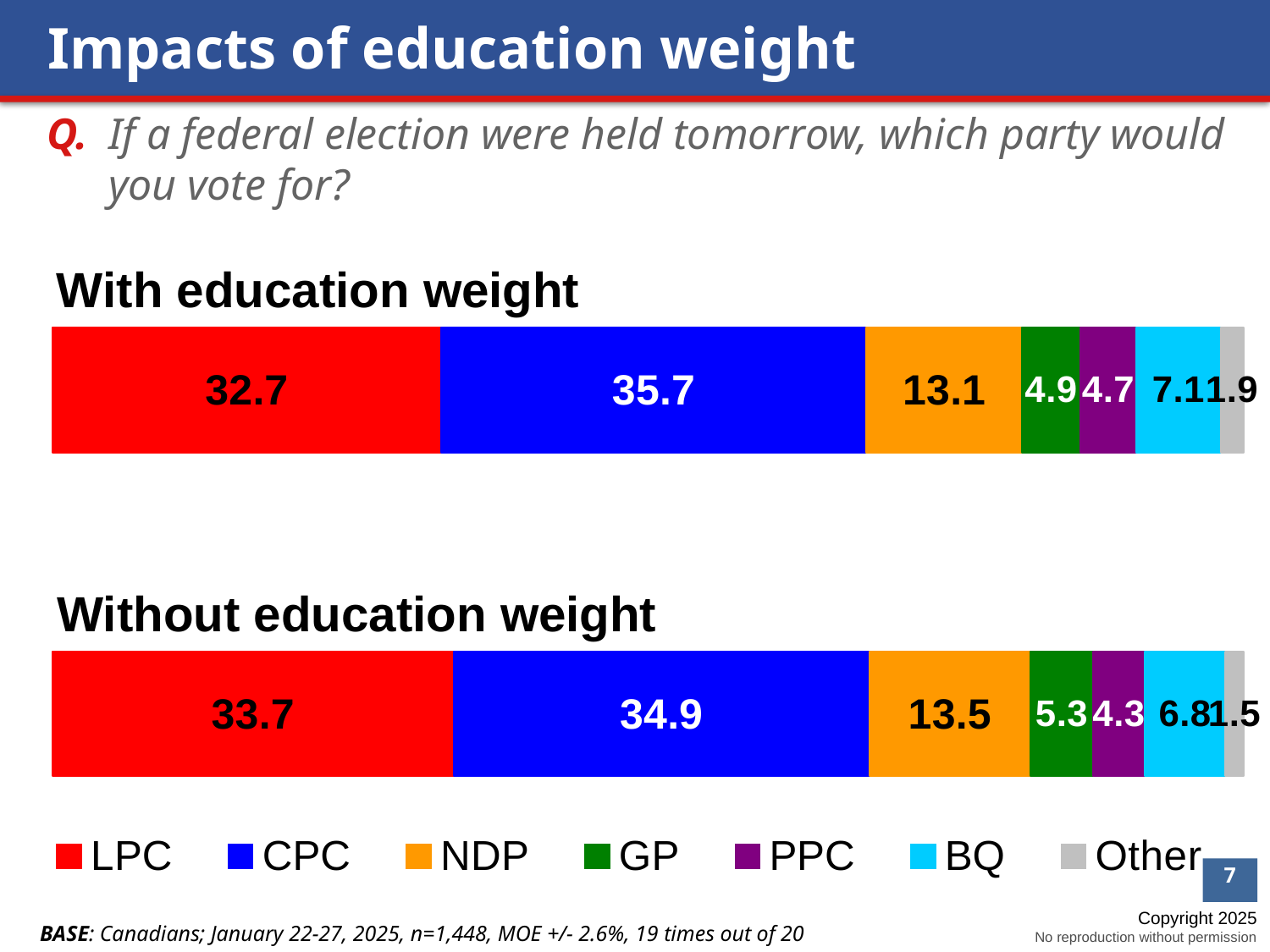
How many series does the legend list? 7 In the 'Without education weight' chart, what is the difference between the NDP and BQ values? 6.7 In the 'Without education weight' chart, which is larger, the GP value or the PPC value? GP In the 'With education weight' chart, what is the value for CPC? 35.7 Which colour represents NDP in the legend? Orange In the 'Without education weight' chart, what is the value for BQ? 6.8 In the 'With education weight' chart, what is the value for NDP? 13.1 In the 'Without education weight' chart, what is the value for LPC? 33.7 What kind of chart is used on this slide? Stacked bar chart In the 'Without education weight' chart, which segment has the lowest value? Other In the 'With education weight' chart, which party has the highest value? CPC In the 'With education weight' chart, what is the difference between the CPC and LPC values? 3.0